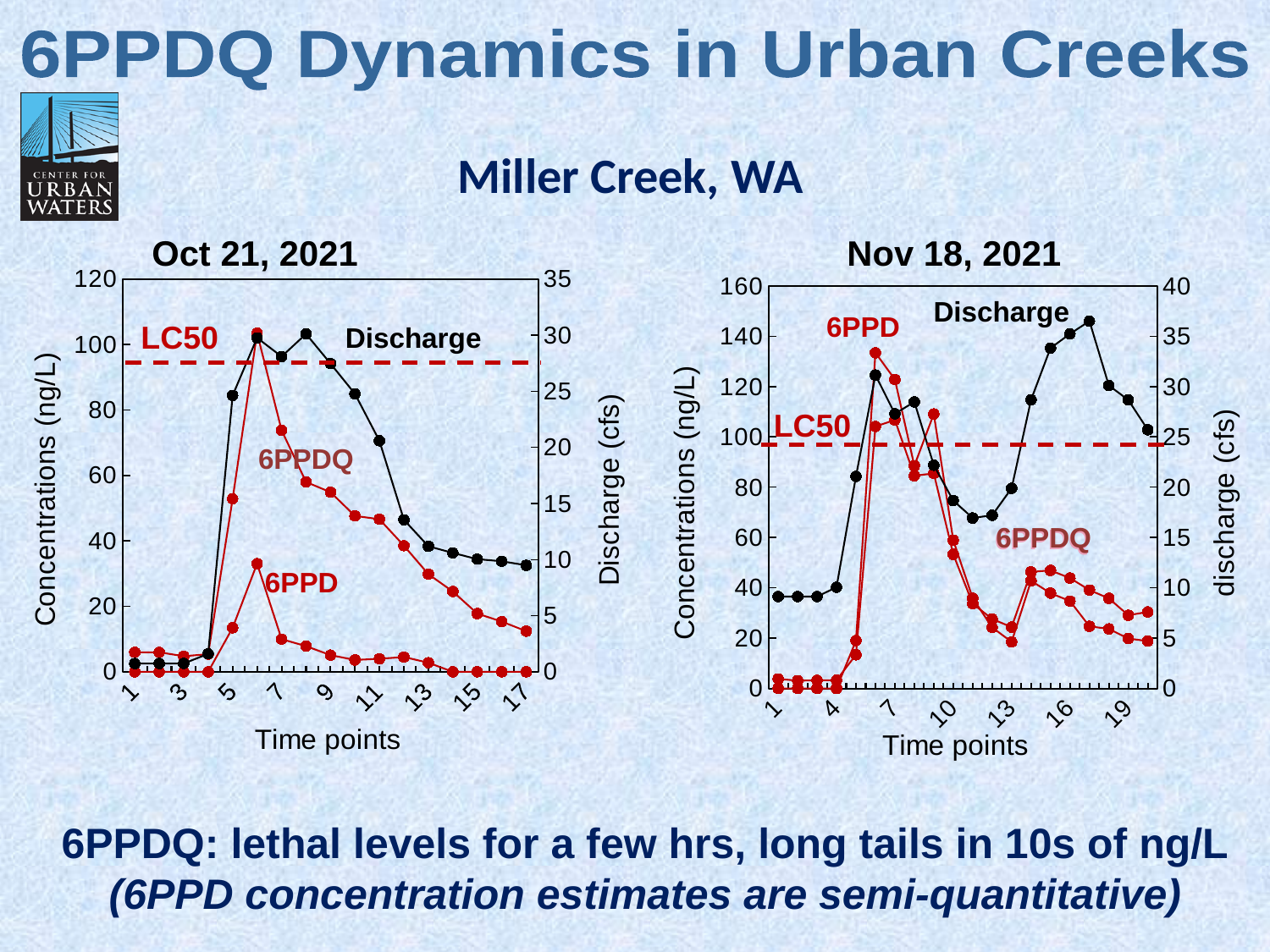
On the Oct 21, 2021 chart, how many time points are plotted along the x axis? 17 On the Oct 21, 2021 chart, does discharge rise or fall from time point 8 to time point 17? fall On the Oct 21, 2021 chart, at which time point does 6PPD reach its highest value? 6 On the Oct 21, 2021 chart, at time point 6, which is larger: 6PPDQ or 6PPD? 6PPDQ What kind of chart is the Oct 21, 2021 chart? line chart On the Nov 18, 2021 chart, does 6PPDQ rise or fall from time point 14 to time point 20? fall On the Oct 21, 2021 chart, is the 6PPD value at time point 6 greater or less than 20 ng/L? greater On the Oct 21, 2021 chart, is the 6PPDQ value at time point 6 greater or less than 80 ng/L? greater On the Nov 18, 2021 chart, is the 6PPD value at time point 6 greater or less than 120 ng/L? greater What is the label of the right-hand y axis on the Oct 21, 2021 chart? Discharge (cfs)